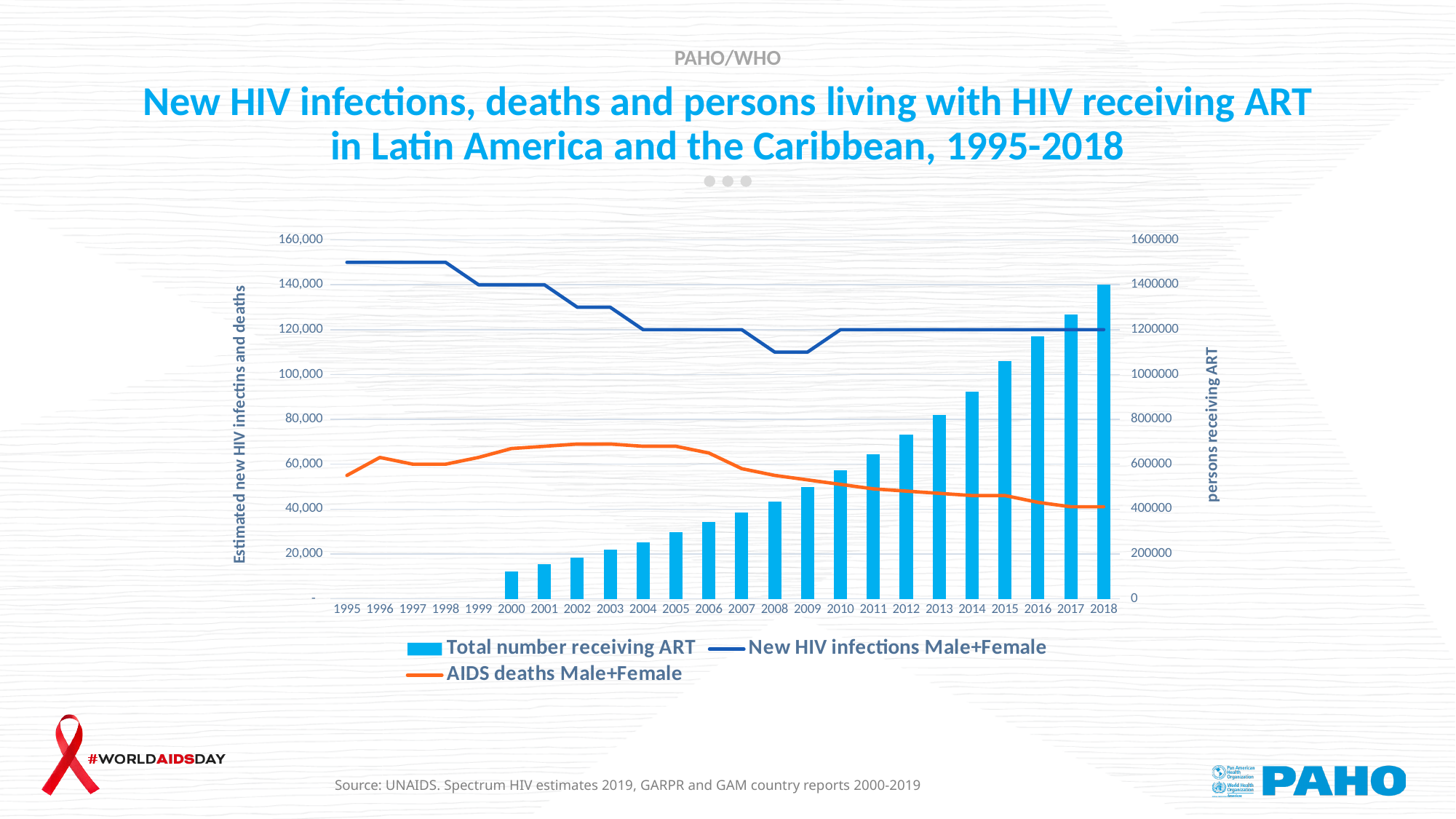
Which is larger: AIDS deaths Male+Female in 2005 or in 2018? 2005 What kind of chart is this? Combined bar and line chart How many series does the legend list? 3 Which year has the highest total number receiving ART? 2018 Is the total number receiving ART in 2018 greater or less than 1200000? greater Is the total number receiving ART in 2000 greater or less than 200000? less Does the total number receiving ART rise or fall from 2000 to 2018? Rise How many years are shown on the x axis? 24 Is the number of new HIV infections Male+Female in 1995 greater or less than 140,000? greater Which series is shown with an orange line? AIDS deaths Male+Female Which year has the lowest non-zero bar for total number receiving ART? 2000